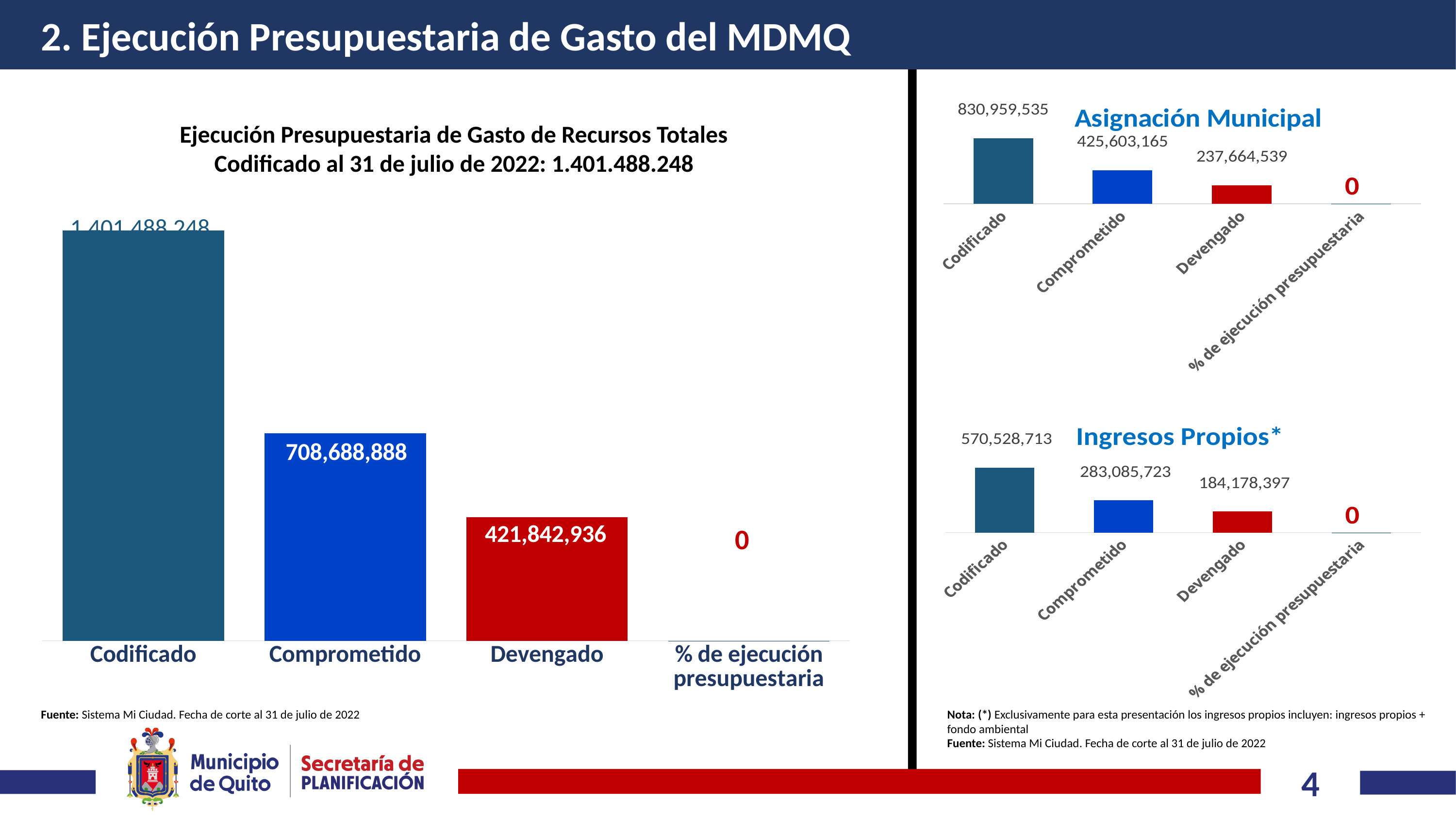
How many categories are shown on the x axis of the 'Ingresos Propios*' chart? 4 In the 'Ingresos Propios*' chart, what is the value for Devengado? 184,178,397 In the 'Ingresos Propios*' chart, what is the value for Comprometido? 283,085,723 In the 'Ejecución Presupuestaria de Gasto de Recursos Totales' chart, what is the value for Comprometido? 708,688,888 Which is larger: Codificado in the 'Asignación Municipal' chart or Codificado in the 'Ingresos Propios*' chart? Asignación Municipal In the 'Asignación Municipal' chart, what is the value for Codificado? 830,959,535 In the 'Ejecución Presupuestaria de Gasto de Recursos Totales' chart, what is the value for Devengado? 421,842,936 In the 'Asignación Municipal' chart, what is the difference between Comprometido and Devengado? 187,938,626 In the 'Asignación Municipal' chart, what is the value for Devengado? 237,664,539 In the 'Ejecución Presupuestaria de Gasto de Recursos Totales' chart, what is the difference between Comprometido and Devengado? 286,845,952 What kind of chart is the 'Asignación Municipal' chart? Bar chart In the 'Ejecución Presupuestaria de Gasto de Recursos Totales' chart, which category has the highest value? Codificado